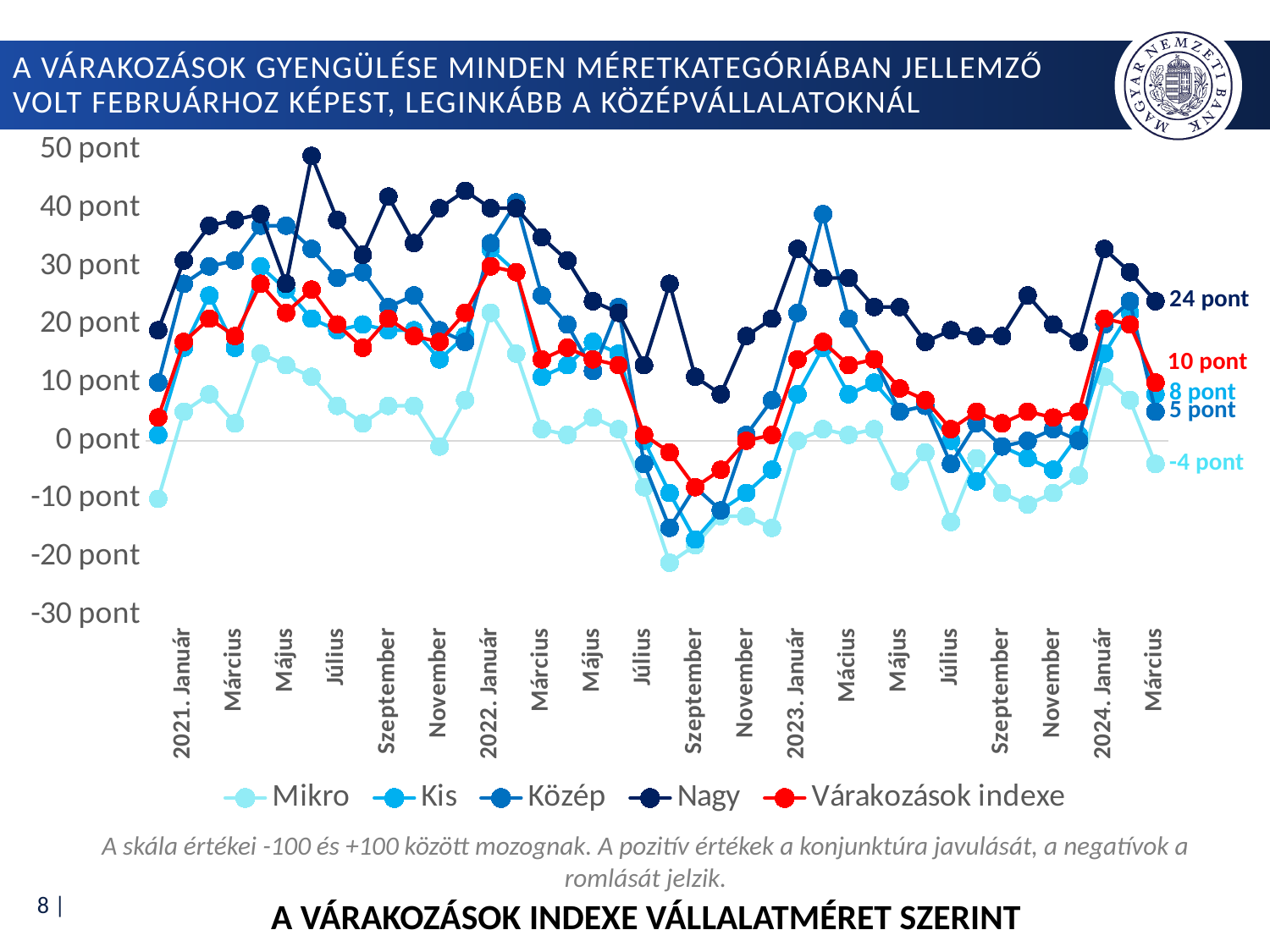
What is the value of the Kis series at the end of the chart (2024 March)? 8 pont What kind of chart is shown on the slide? line chart Which series has the lowest value at the last data point (2024 March)? Mikro What is the value of the Mikro series at the end of the chart (2024 March)? -4 pont What is the value of the Nagy series at the end of the chart (2024 March)? 24 pont How many series does the legend of the chart list? 5 What is the title of the chart shown at the bottom of the slide? A VÁRAKOZÁSOK INDEXE VÁLLALATMÉRET SZERINT What is the value of the Közép series at the end of the chart (2024 March)? 5 pont At the last data point (2024 March), what is the difference between the Nagy series and the Várakozások indexe series? 14 pont Which series has the highest value at the last data point (2024 March)? Nagy What is the value of the Várakozások indexe series at the end of the chart (2024 March)? 10 pont